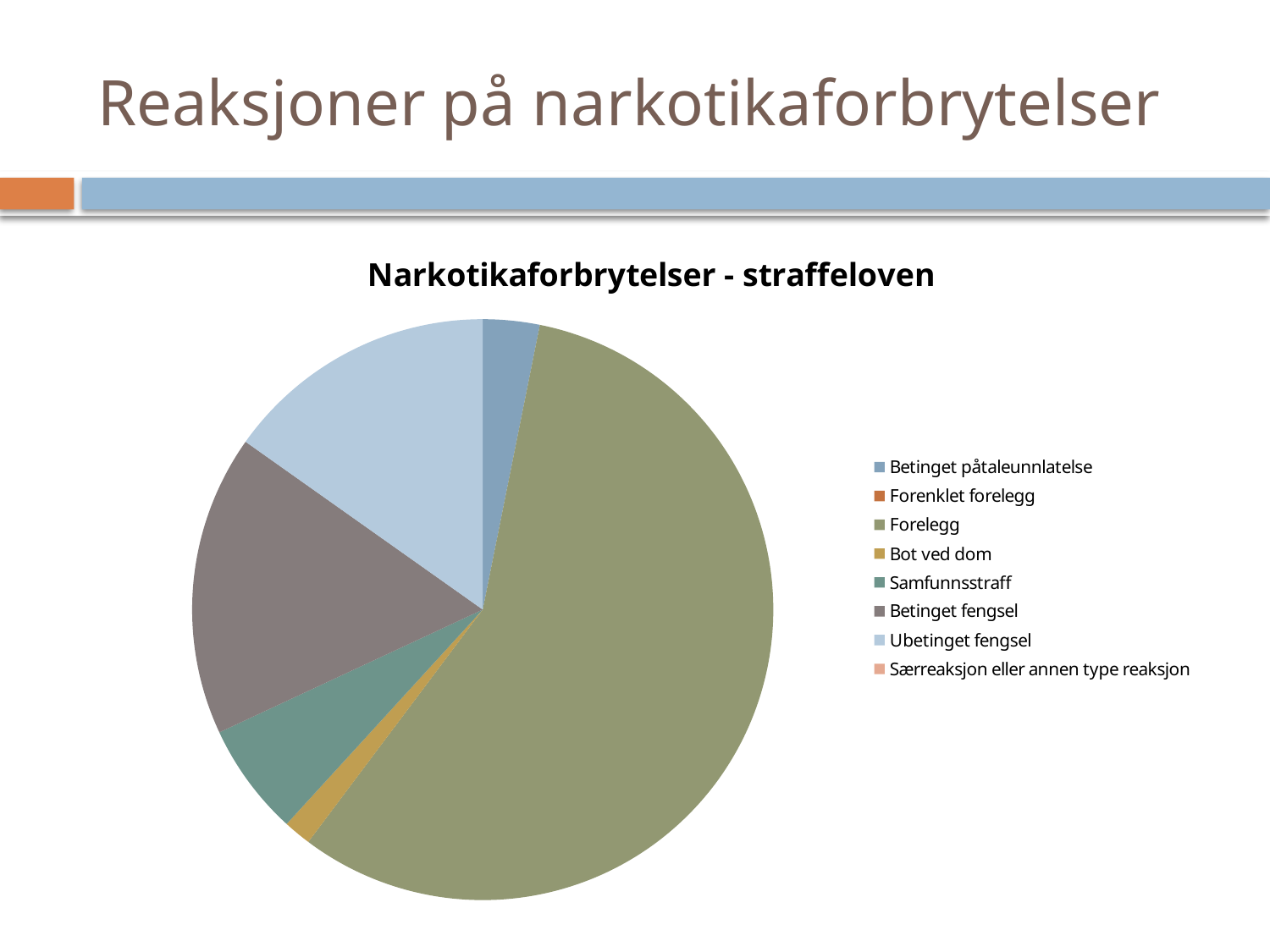
Which legend entry is listed first in the chart legend? Betinget påtaleunnlatelse Which is larger, the slice for Betinget fengsel or the slice for Samfunnsstraff? Betinget fengsel Which is larger, the slice for Forelegg or the slice for Ubetinget fengsel? Forelegg Which category has the largest slice of the pie? Forelegg How many entries does the chart legend list? 8 Is the share for Forelegg greater or less than 50%? greater What kind of chart is shown on the slide? pie chart Which is larger, the slice for Samfunnsstraff or the slice for Bot ved dom? Samfunnsstraff What is the title of the chart? Narkotikaforbrytelser - straffeloven